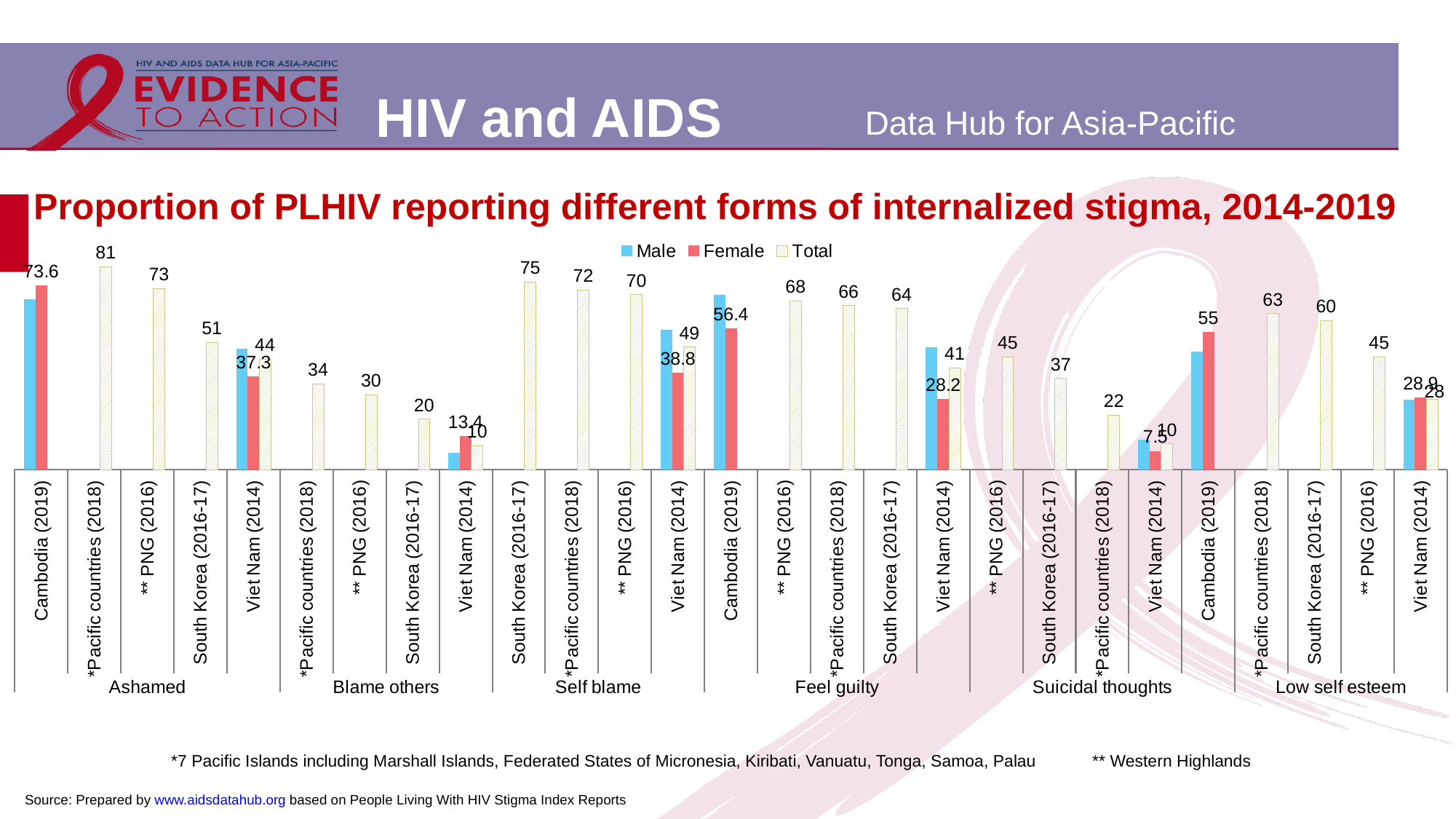
What is the Female value for Viet Nam (2014) in the Suicidal thoughts group? 7.5 How many series does the legend list? 3 What is the Total value for Viet Nam (2014) in the Feel guilty group? 41 What are the three series named in the legend? Male, Female, Total What kind of chart is shown on the slide? bar chart What is the Total value for *Pacific countries (2018) in the Ashamed group? 81 What is the difference between the Total value for ** PNG (2016) in the Ashamed group and in the Blame others group? 43 How many forms of internalized stigma are shown as groups along the x axis? 6 Which country has the highest Total value in the Ashamed group? *Pacific countries (2018) In the Low self esteem group, which has the larger Total value: South Korea (2016-17) or ** PNG (2016)? South Korea (2016-17) What is the Total value for South Korea (2016-17) in the Self blame group? 75 Which country has the lowest Total value in the Blame others group? Viet Nam (2014)